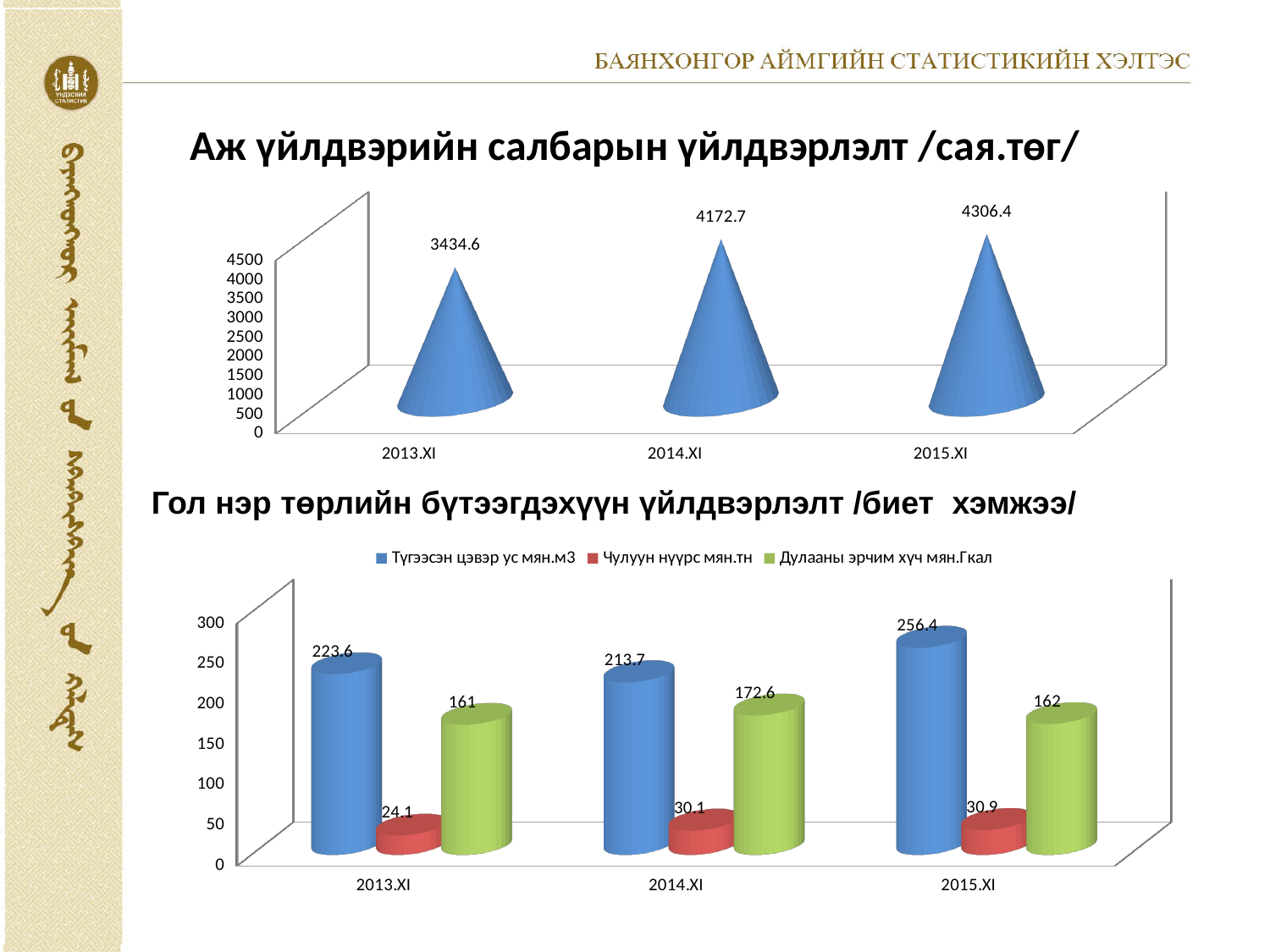
In the bottom chart (Гол нэр төрлийн бүтээгдэхүүн үйлдвэрлэлт), what is the difference between Түгээсэн цэвэр ус мян.м3 in 2015.XI and 2014.XI? 42.7 In the top chart (Аж үйлдвэрийн салбарын үйлдвэрлэлт), which period has the highest value? 2015.XI In the top chart (Аж үйлдвэрийн салбарын үйлдвэрлэлт), which period has the lowest value? 2013.XI In the bottom chart (Гол нэр төрлийн бүтээгдэхүүн үйлдвэрлэлт), what is the value of Дулааны эрчим хүч мян.Гкал for 2015.XI? 162 In the bottom chart (Гол нэр төрлийн бүтээгдэхүүн үйлдвэрлэлт), what is the value of Чулуун нүүрс мян.тн for 2014.XI? 30.1 In the bottom chart (Гол нэр төрлийн бүтээгдэхүүн үйлдвэрлэлт), how many series does the legend list? 3 In the bottom chart (Гол нэр төрлийн бүтээгдэхүүн үйлдвэрлэлт), which is larger for 2013.XI: Түгээсэн цэвэр ус мян.м3 or Дулааны эрчим хүч мян.Гкал? Түгээсэн цэвэр ус мян.м3 In the top chart (Аж үйлдвэрийн салбарын үйлдвэрлэлт), how many periods are shown? 3 In the top chart (Аж үйлдвэрийн салбарын үйлдвэрлэлт), what is the value for 2014.XI? 4172.7 In the top chart (Аж үйлдвэрийн салбарын үйлдвэрлэлт), what is the difference between the 2015.XI and 2013.XI values? 871.8 In the bottom chart (Гол нэр төрлийн бүтээгдэхүүн үйлдвэрлэлт), which period has the highest value for Түгээсэн цэвэр ус мян.м3? 2015.XI In the top chart (Аж үйлдвэрийн салбарын үйлдвэрлэлт), do the values rise or fall from 2013.XI to 2015.XI? rise